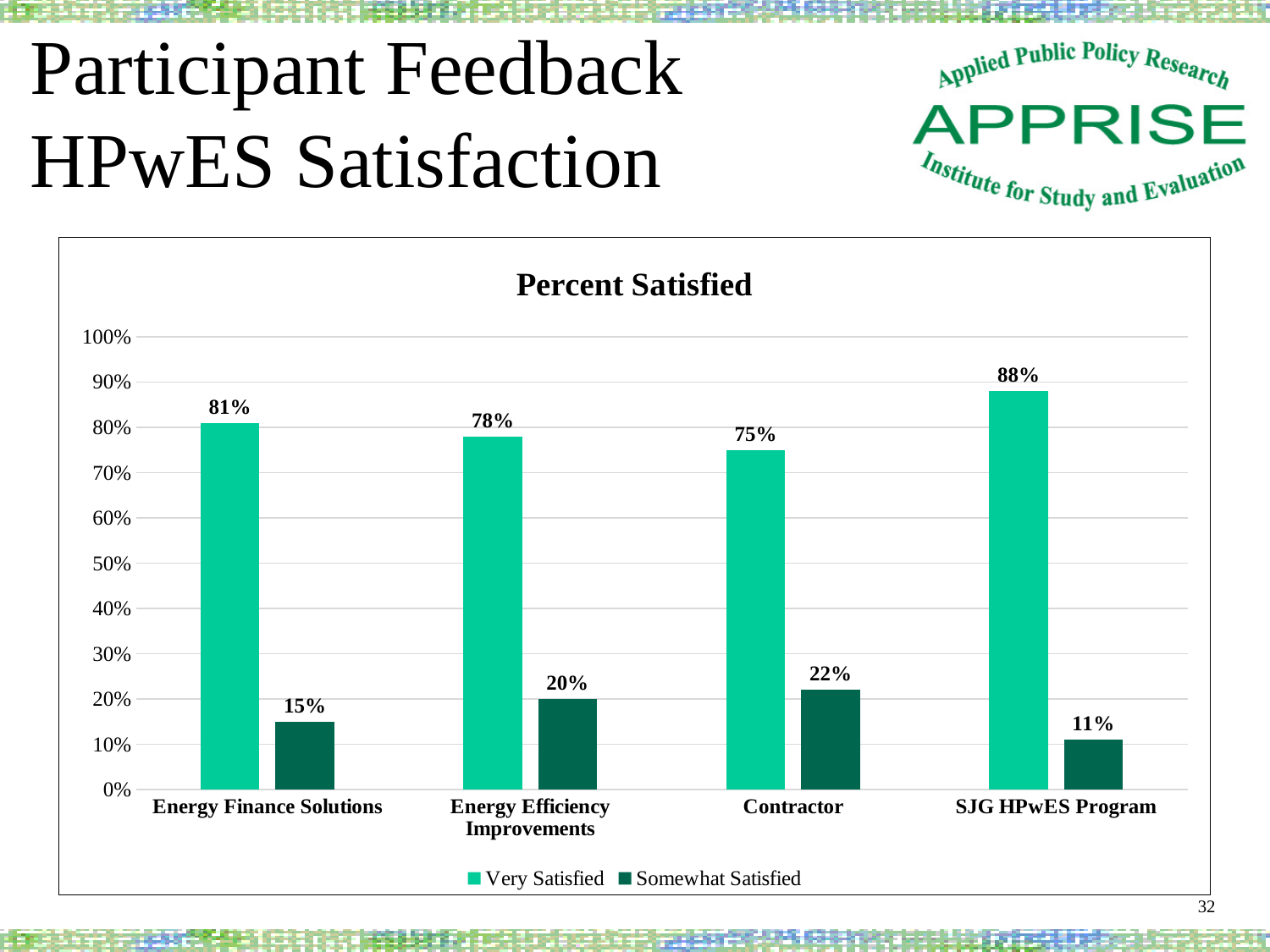
Which category has the highest Very Satisfied value? SJG HPwES Program What is the difference between the Very Satisfied values for SJG HPwES Program and Contractor? 13% How many series does the legend list? 2 Which category has the lowest Somewhat Satisfied value? SJG HPwES Program What is the title of the chart? Percent Satisfied What is the Very Satisfied value for Energy Finance Solutions? 81% What kind of chart is shown? bar chart Which is larger, the Somewhat Satisfied value for Energy Efficiency Improvements or for Energy Finance Solutions? Energy Efficiency Improvements What is the Very Satisfied value for SJG HPwES Program? 88% Is the Very Satisfied value for Contractor greater or less than 80%? less How many categories are shown on the x axis? 4 What is the Somewhat Satisfied value for Contractor? 22%